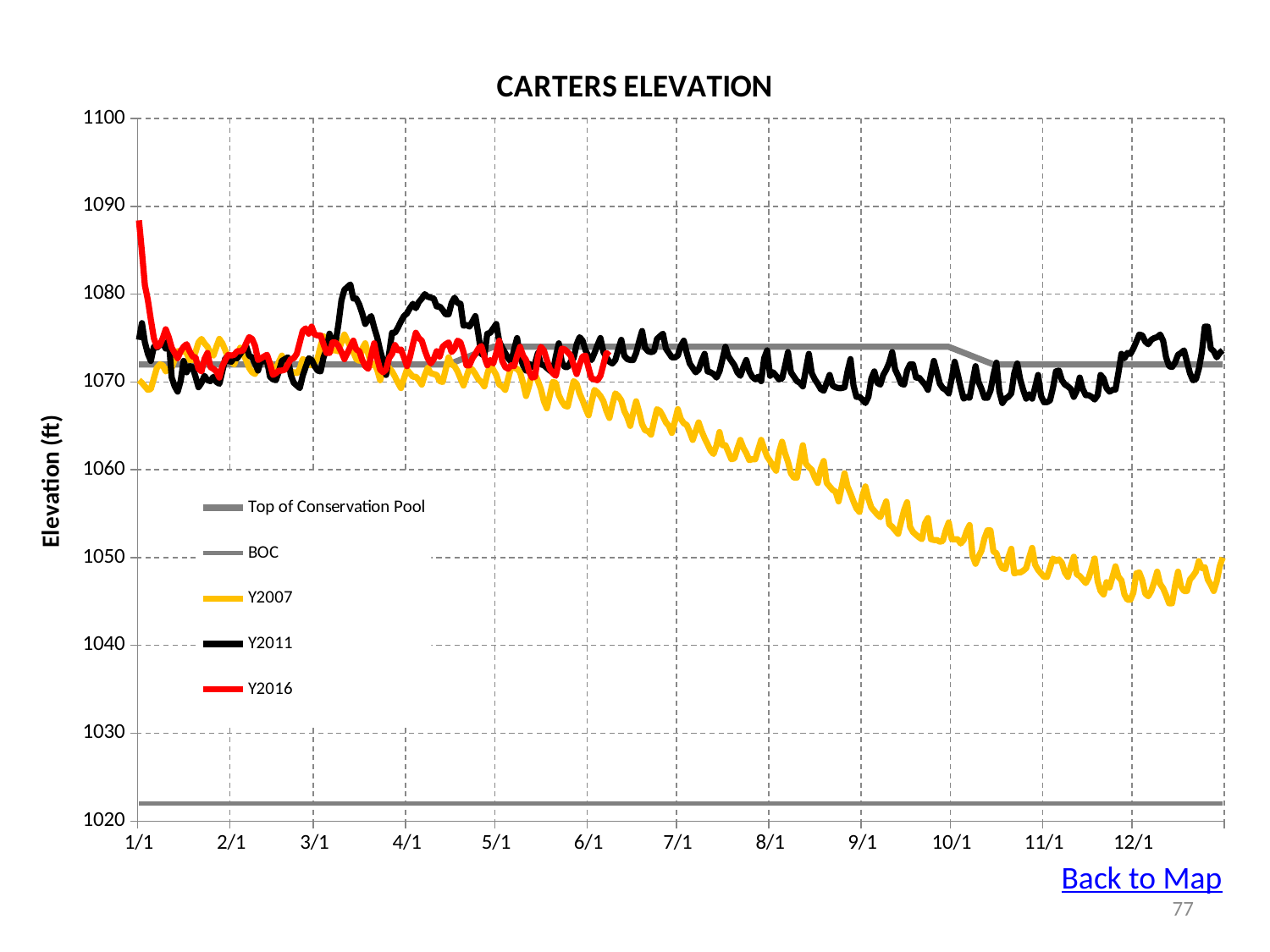
At 12/1, which series has the higher elevation, Y2011 or Y2007? Y2011 How many series does the legend list? 5 Is the Y2016 elevation at 1/1 greater or less than 1080? greater Does the Y2007 elevation generally rise or fall from 1/1 to the end of the year? fall Is the Y2007 elevation at 7/1 greater or less than 1060? greater Is the Y2007 elevation at 12/1 greater or less than 1050? less What type of chart is shown on the slide? line chart What is the label of the vertical axis? Elevation (ft) Which series reaches the highest elevation shown on the chart? Y2016 What is the title of the chart? CARTERS ELEVATION